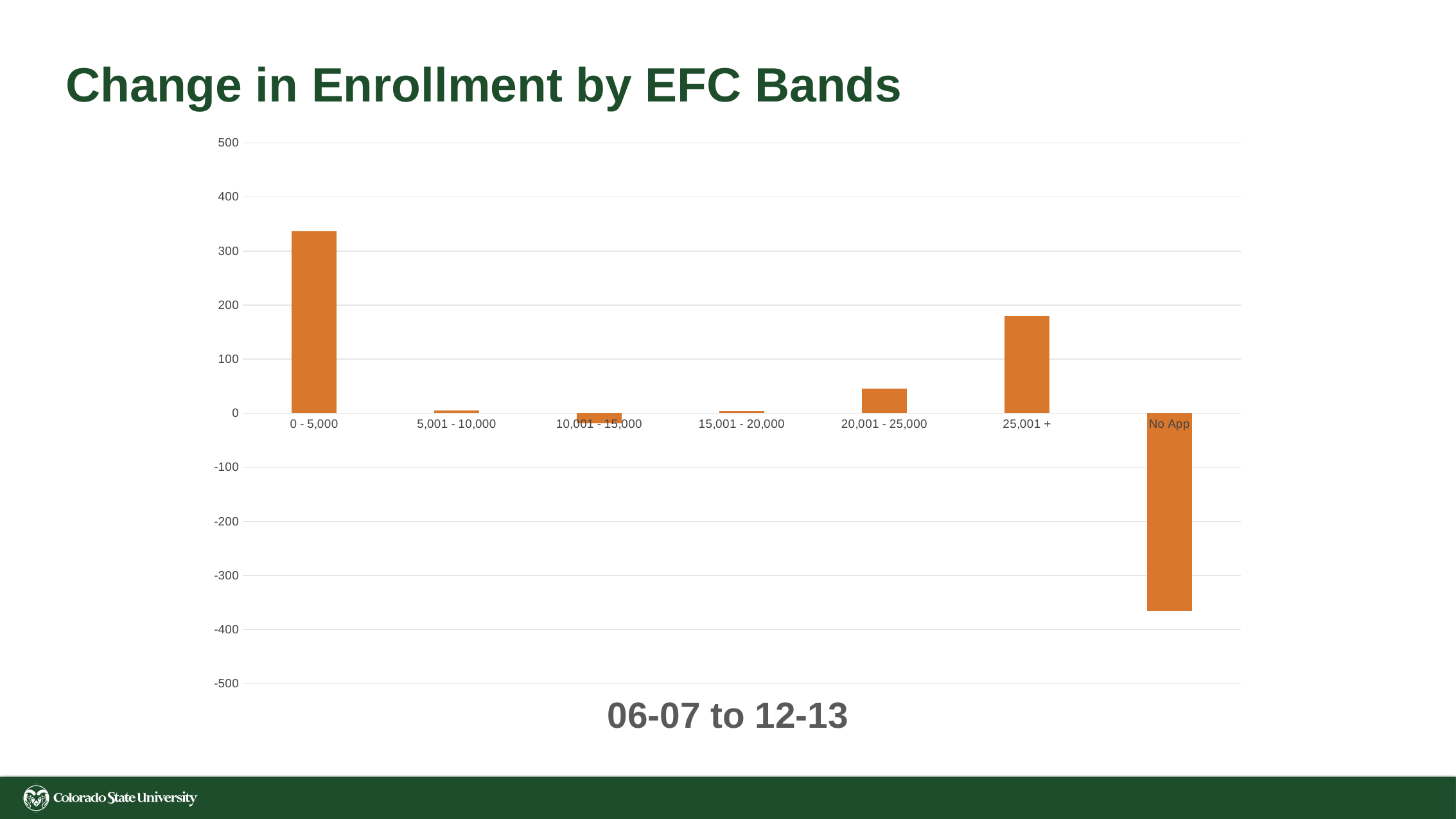
What time period is shown in the text below the chart? 06-07 to 12-13 What is the title of the chart on the slide? Change in Enrollment by EFC Bands What kind of chart is shown on the slide? bar chart Is the value for 20,001 - 25,000 greater or less than 100? less Is the value for 25,001 + greater or less than 200? less Is the value for 0 - 5,000 greater or less than 300? greater Which category has the lowest change in enrollment? No App How many EFC band categories are plotted on the chart? 7 Which is larger, the value for 0 - 5,000 or the value for 25,001 +? 0 - 5,000 Which category has the highest change in enrollment? 0 - 5,000 Which is larger, the value for 25,001 + or the value for 20,001 - 25,000? 25,001 +